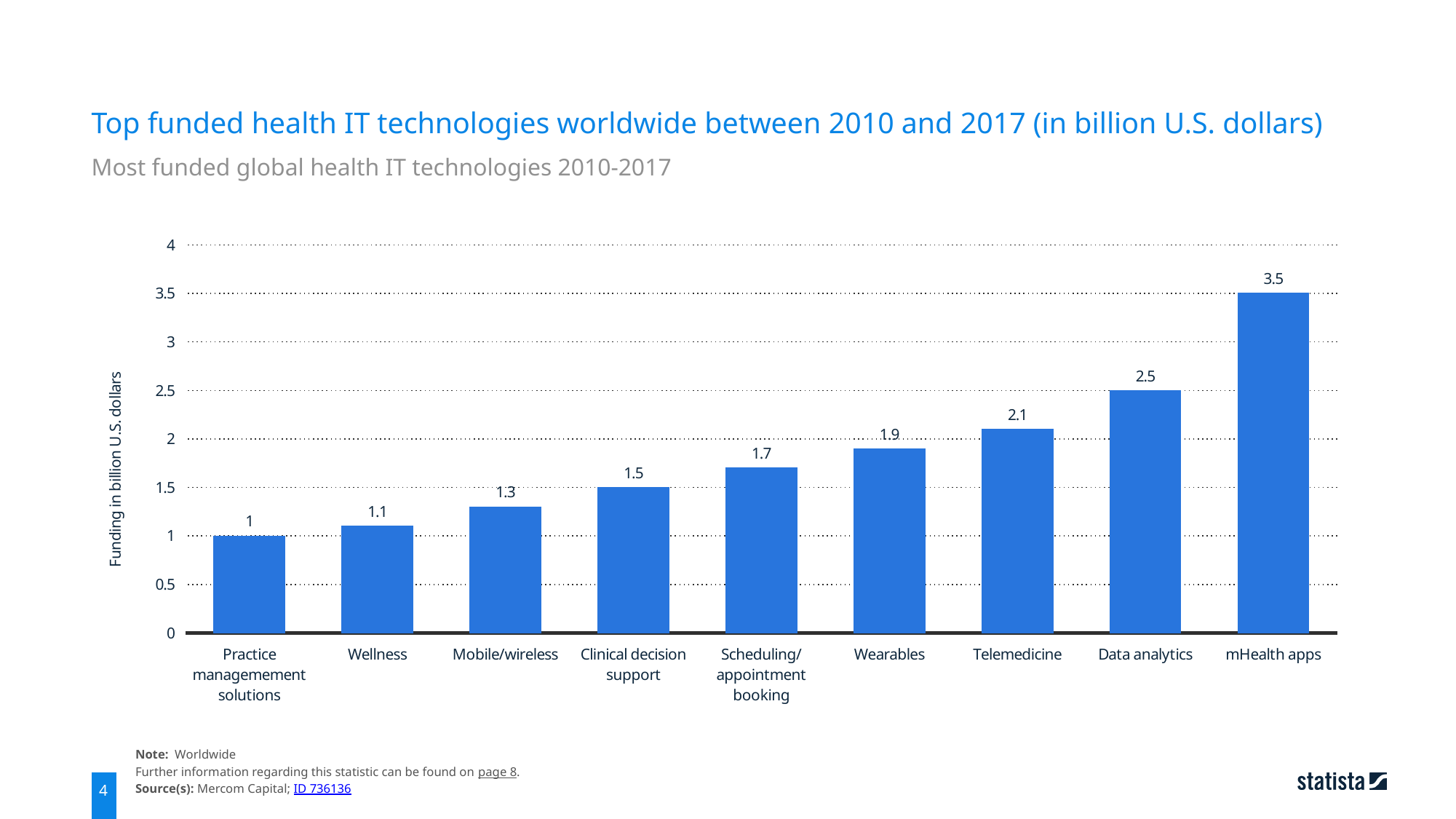
What kind of chart is shown on the slide? bar chart Which category has the highest funding? mHealth apps How many categories are shown in the chart? 9 Which has higher funding, Mobile/wireless or Clinical decision support? Clinical decision support What is the difference in funding between Wearables and Wellness? 0.8 What is the funding value for Telemedicine? 2.1 Do the values rise or fall from left to right along the x axis? rise Which category has the lowest funding? Practice management solutions What is the funding value for Scheduling/appointment booking? 1.7 What is the difference in funding between mHealth apps and Data analytics? 1 What is the funding value for mHealth apps? 3.5 Is the value for Data analytics greater or less than 2? greater